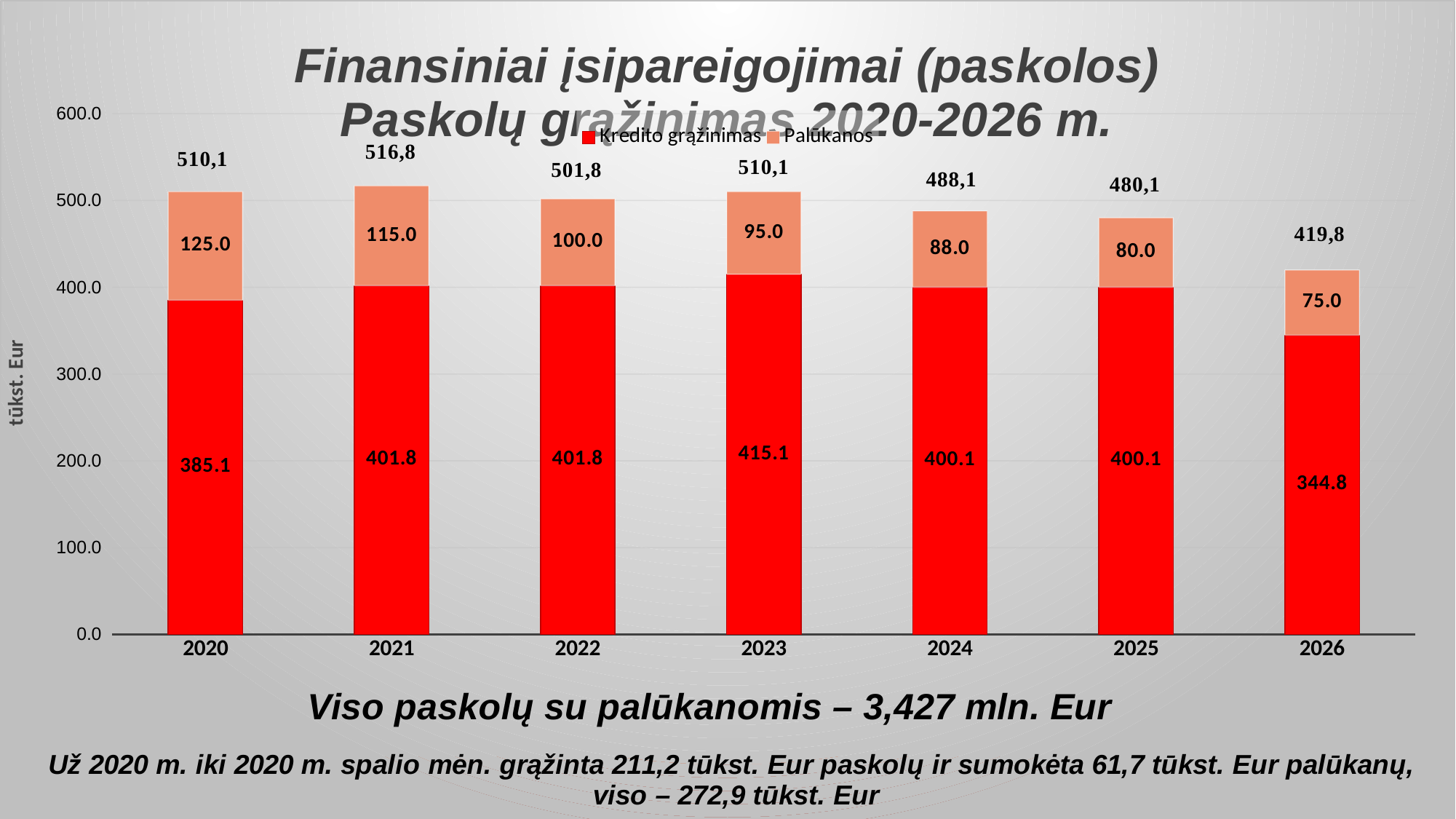
Which is larger, the Kredito grąžinimas value for 2020 or for 2021? 2021 What is the Palūkanos value for 2021? 115.0 What kind of chart is shown on the slide? stacked bar chart Is the total for 2024 greater or less than 500? less What is the Kredito grąžinimas value for 2023? 415.1 Which year has the highest Palūkanos value? 2020 Which year has the lowest Kredito grąžinimas value? 2026 What is the difference between the Palūkanos values for 2020 and 2026? 50.0 How many years are shown on the x axis? 7 Do the Palūkanos values rise or fall from 2020 to 2026? fall How many series does the legend list? 2 What is the total shown above the stacked bar for 2026? 419,8